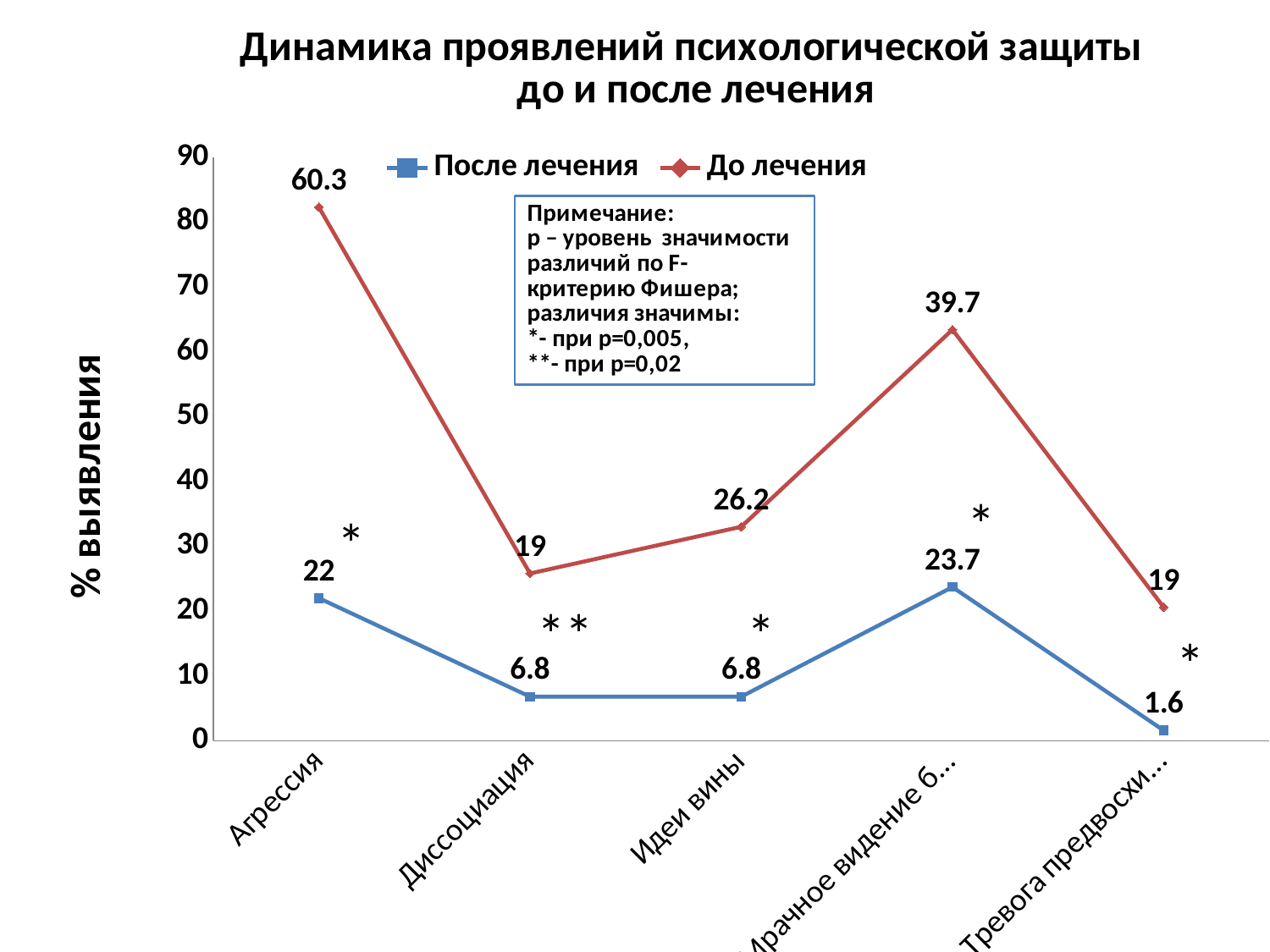
How many series does the legend list? 2 What is the title of the vertical axis? % выявления What is the value for Агрессия in the До лечения series? 60.3 What kind of chart is shown on the slide? line chart What is the difference between the До лечения and После лечения values for Идеи вины? 19.4 What is the difference between the До лечения and После лечения values for Агрессия? 38.3 What is the value for Диссоциация in the После лечения series? 6.8 What is the value for Идеи вины in the До лечения series? 26.2 Which category has the highest value in the До лечения series? Агрессия What is the value for Агрессия in the После лечения series? 22 How many categories are plotted along the x axis? 5 What is the value for Диссоциация in the До лечения series? 19